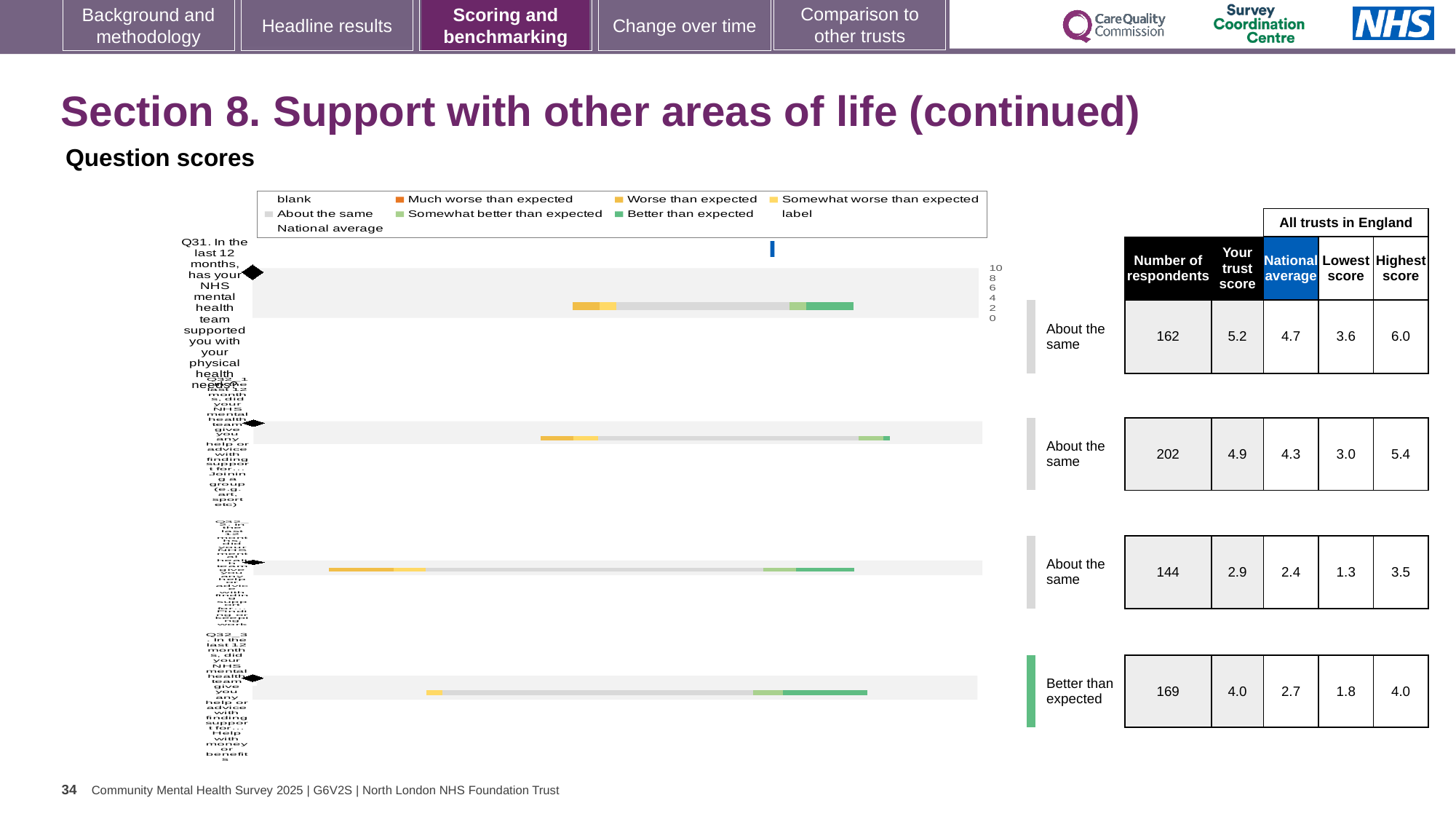
What is the trust score for Q31 (support with physical health needs)? 5.2 What is the highest score across all trusts in England for Q31? 6.0 For Q31, which is larger: the trust score or the national average? the trust score How many entries does the chart legend list? 9 What benchmark rating is given to the fourth (bottom) question bar? Better than expected What is the difference between the trust score and the national average for Q31? 0.5 What colour does the legend use for 'Better than expected'? green What kind of chart is shown on the slide? bar chart How many question bars are plotted in the chart? 4 What is the national average for Q31 (support with physical health needs)? 4.7 What is the number of respondents for Q31 (support with physical health needs)? 162 Which question row has the highest number of respondents? the second row (202)